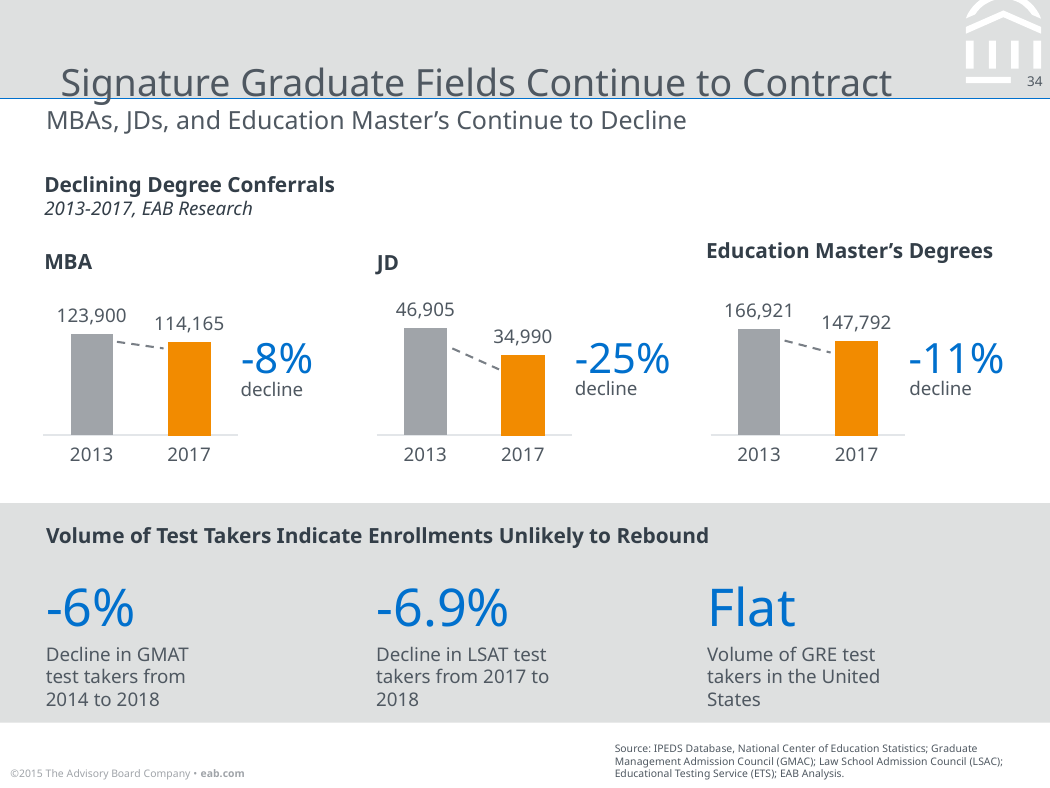
In the JD chart, which year has the lowest value? 2017 What kind of chart is the Education Master's Degrees chart? Bar chart How many bars are in the JD chart? 2 In the MBA chart, what is the value for 2013? 123,900 In the JD chart, what is the difference between the 2013 and 2017 values? 11,915 In the MBA chart, which year has the higher value, 2013 or 2017? 2013 In the MBA chart, what is the value for 2017? 114,165 In the Education Master's Degrees chart, what is the value for 2013? 166,921 In the Education Master's Degrees chart, do the values rise or fall from 2013 to 2017? Fall In the Education Master's Degrees chart, what is the difference between the 2013 and 2017 values? 19,129 In the JD chart, what is the value for 2017? 34,990 What percentage decline is shown next to the JD chart? -25%